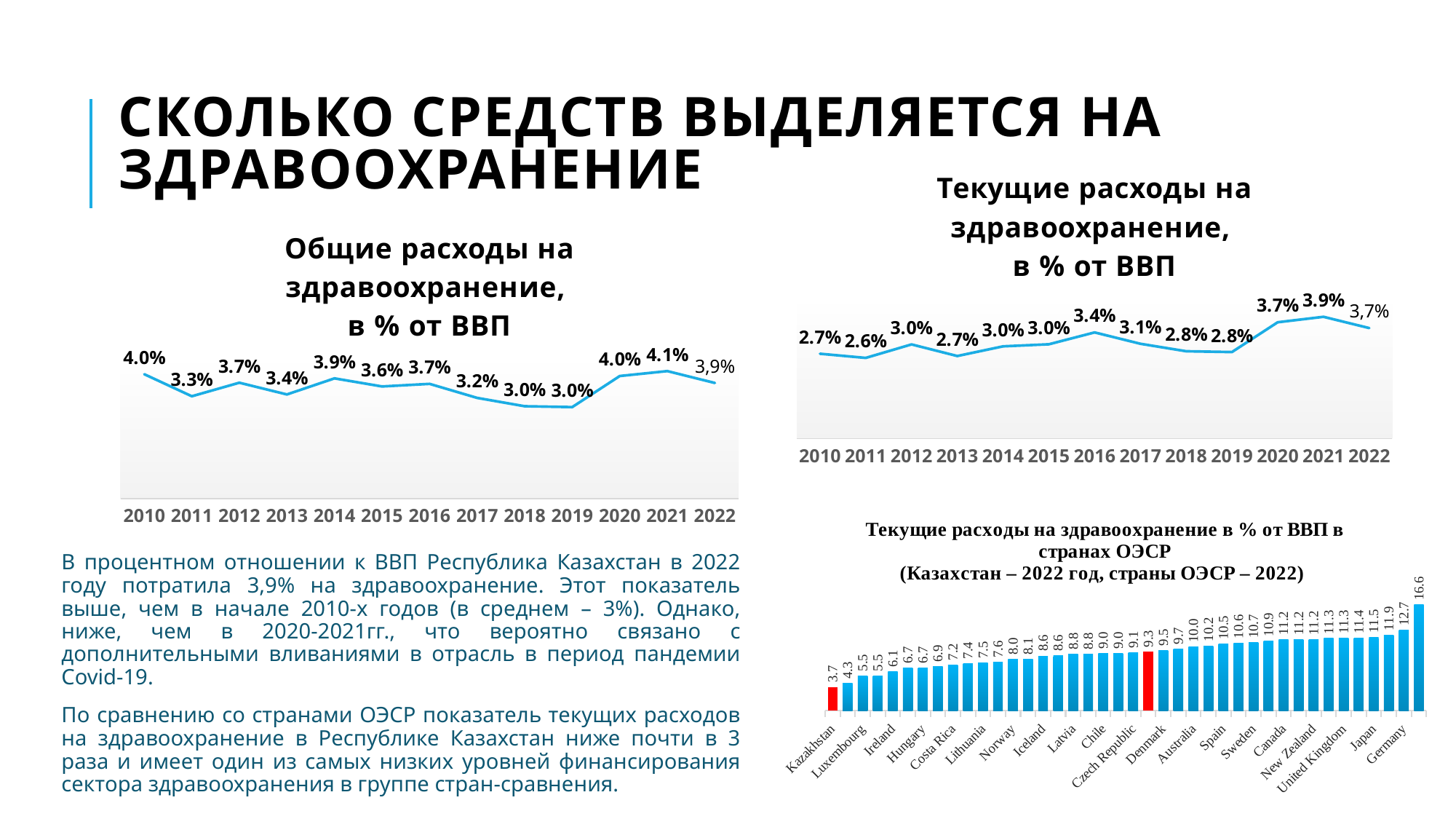
In the chart 'Текущие расходы на здравоохранение, в % от ВВП', which is larger, the value for 2020 or the value for 2021? 2021 In the chart 'Общие расходы на здравоохранение, в % от ВВП', which year has the highest value? 2021 How many years are plotted in the chart 'Текущие расходы на здравоохранение, в % от ВВП'? 13 In the chart 'Общие расходы на здравоохранение, в % от ВВП', what is the value for 2010? 4.0% In the bar chart of current health expenditure in OECD countries (bottom right), what colour is the bar for Kazakhstan? Red In the chart 'Общие расходы на здравоохранение, в % от ВВП', what is the difference between the values for 2021 and 2017? 0.9% What type of chart is 'Общие расходы на здравоохранение, в % от ВВП'? Line chart In the bar chart of current health expenditure in OECD countries (bottom right), what is the value for Kazakhstan? 3.7 In the chart 'Текущие расходы на здравоохранение, в % от ВВП', what is the value for 2016? 3.4% In the chart 'Общие расходы на здравоохранение, в % от ВВП', what is the value for 2022? 3,9% In the chart 'Текущие расходы на здравоохранение, в % от ВВП', which year has the lowest value? 2011